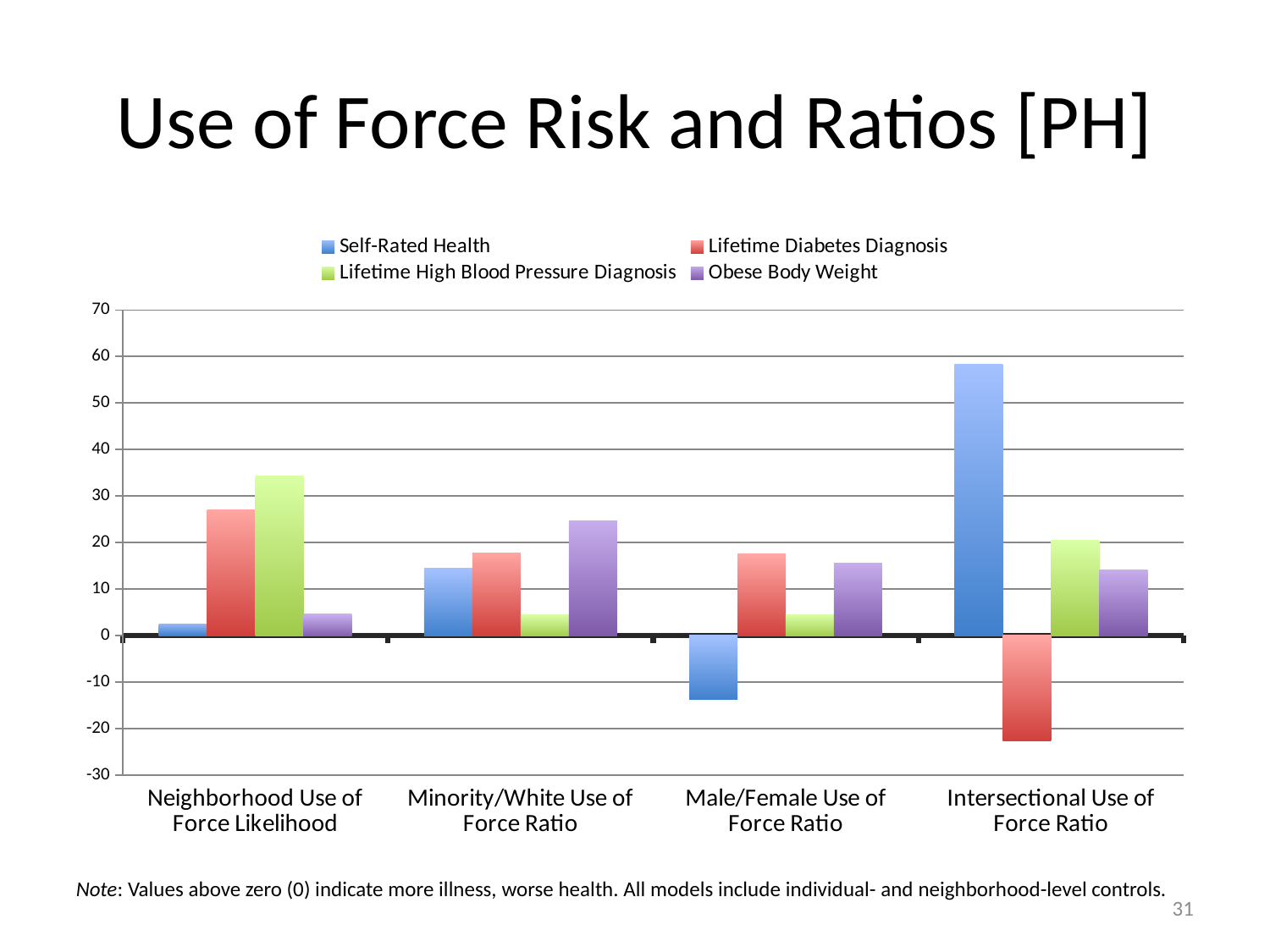
For which category is the Lifetime Diabetes Diagnosis bar lowest? Intersectional Use of Force Ratio Is the Self-Rated Health value for Intersectional Use of Force Ratio greater or less than 50? greater For Neighborhood Use of Force Likelihood, which is larger: Lifetime Diabetes Diagnosis or Lifetime High Blood Pressure Diagnosis? Lifetime High Blood Pressure Diagnosis What colour represents Obese Body Weight in the legend? Purple Is the Lifetime High Blood Pressure Diagnosis value for Neighborhood Use of Force Likelihood greater or less than 30? greater How many series does the legend list? 4 For which category is the Self-Rated Health bar highest? Intersectional Use of Force Ratio For Minority/White Use of Force Ratio, which is larger: Obese Body Weight or Lifetime Diabetes Diagnosis? Obese Body Weight Is the Self-Rated Health value for Male/Female Use of Force Ratio greater or less than -10? less What kind of chart is shown on the slide? Bar chart How many categories are shown along the x axis? 4